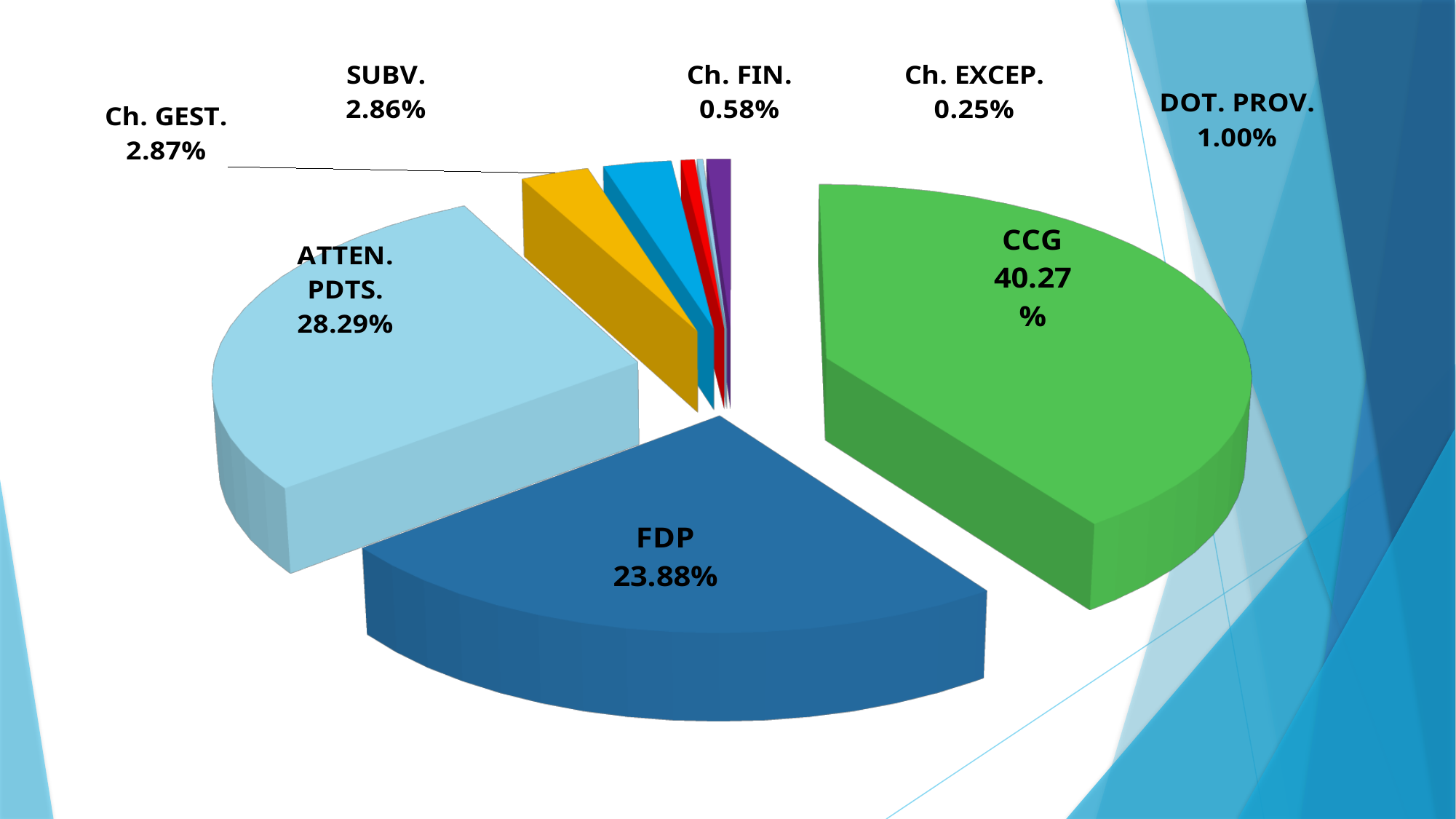
What kind of chart is shown on the slide? pie chart What is the value shown for Ch. FIN.? 0.58% What is the value shown for DOT. PROV.? 1.00% How many slices does the pie chart have? 8 What colour is the CCG slice? green What is the value shown for ATTEN. PDTS.? 28.29% What is the value shown for FDP? 23.88% Which slice of the pie is the largest? CCG Which is larger, the share for ATTEN. PDTS. or the share for FDP? ATTEN. PDTS. Which slice of the pie is the smallest? Ch. EXCEP. What is the difference between the CCG share and the FDP share? 16.39% What share of the pie does CCG represent? 40.27%